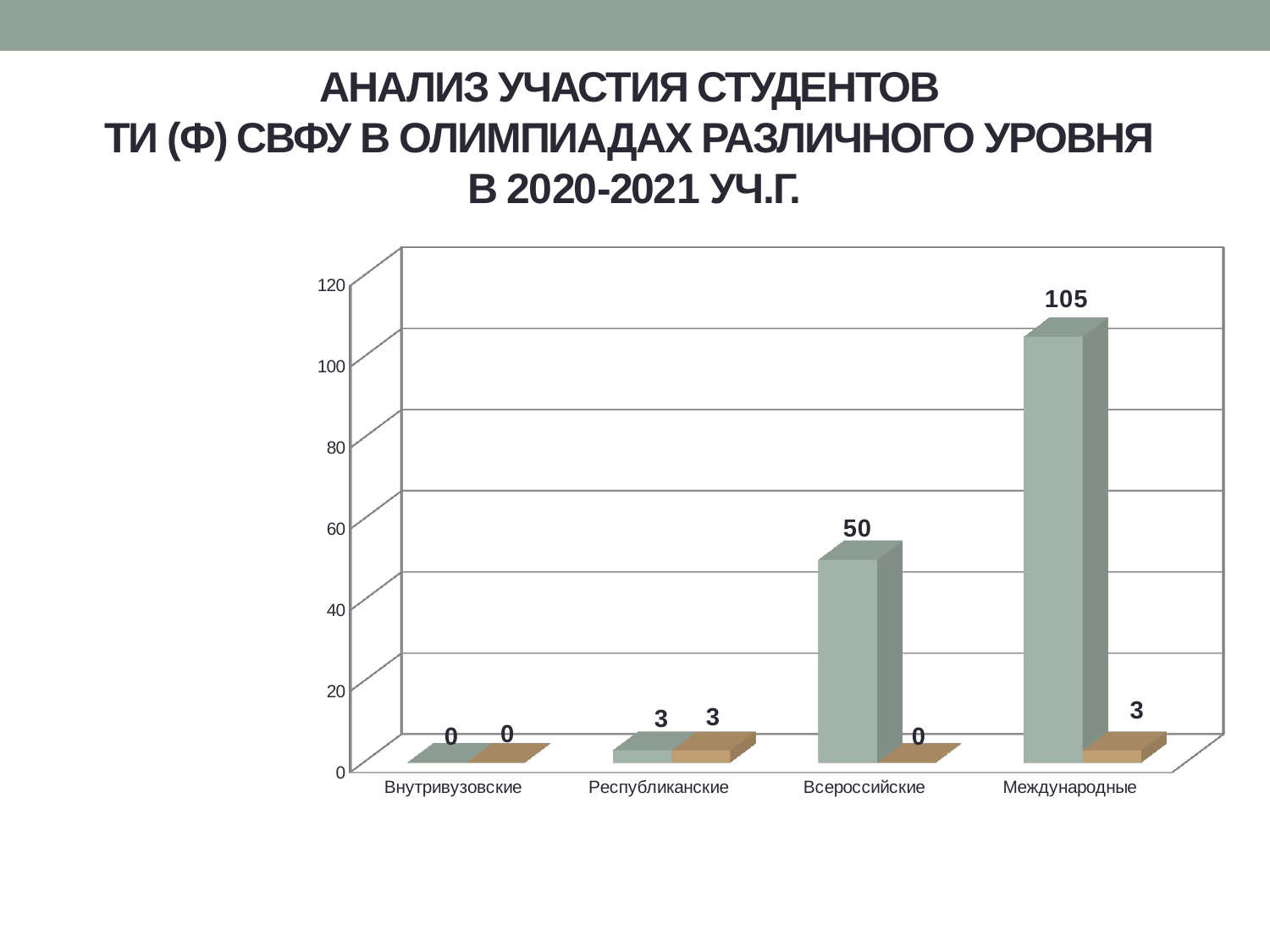
What is the value of the green bar for Всероссийские? 50 What type of chart is shown on the slide? bar chart How many categories are shown on the x axis of the chart? 4 What is the value of the tan bar for Всероссийские? 0 What is the value of the tan bar for Международные? 3 Which category has the highest green bar? Международные What is the difference between the green bar values for Международные and Всероссийские? 55 Which is larger: the green bar for Всероссийские or the green bar for Республиканские? Всероссийские What is the value of the green bar for Республиканские? 3 What is the value of the green bar for Международные? 105 Do the green bar values rise or fall from Внутривузовские to Международные? rise Is the green bar value for Международные greater or less than 100? greater